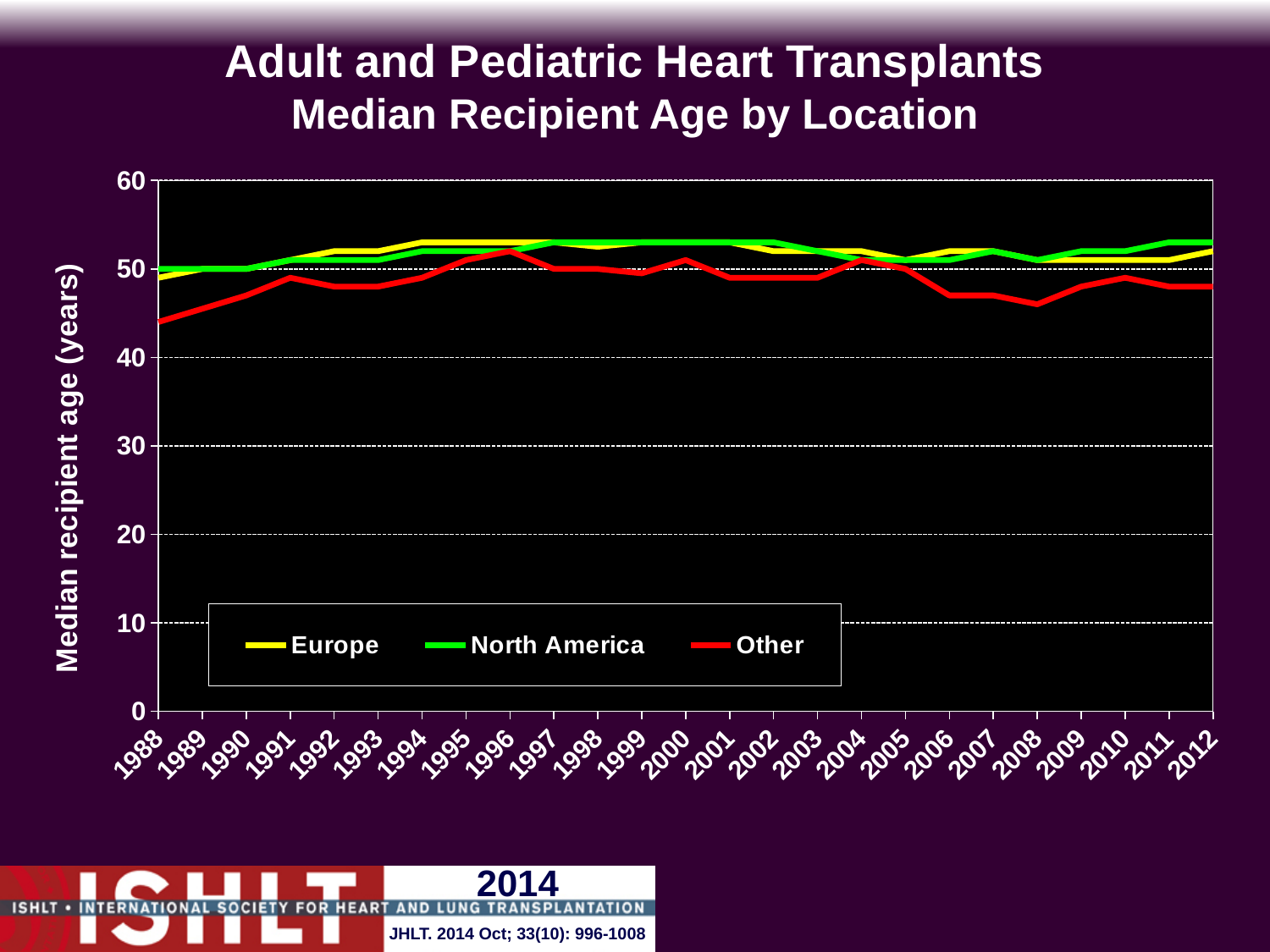
Is the value for Other in 2008 greater or less than 50? less How many years are shown along the x axis? 25 What kind of chart is shown on the slide? line chart How many series does the legend list? 3 What is the label on the y axis? Median recipient age (years) Does the Other series rise or fall from 1988 to 1991? rise In 1988, which is larger: the value for Europe or the value for Other? Europe Is the value for Europe in 1994 greater or less than 50? greater Which series has the lowest value in 1988? Other Is the value for Other in 1988 greater or less than 50? less In 2008, which is larger: the value for North America or the value for Other? North America